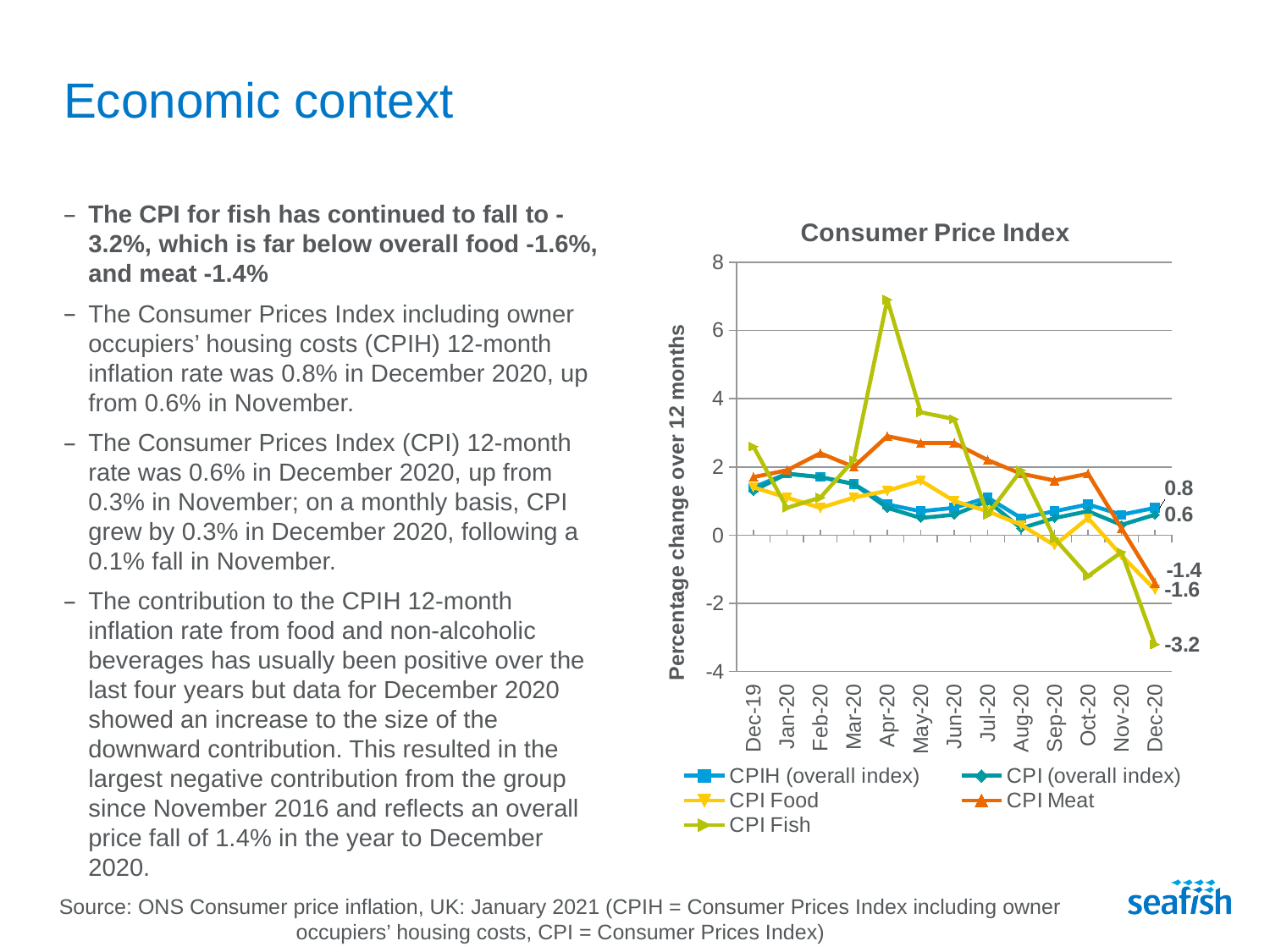
What is the value for CPI Fish in Dec-20? -3.2 What is the value for CPI Food in Dec-20? -1.6 Does the CPI Fish line rise or fall from Apr-20 to Dec-20? fall How many months are shown on the x axis of the Consumer Price Index chart? 13 What type of chart is the Consumer Price Index chart? line chart Is the value for CPI Fish in Apr-20 greater or less than 6? greater What is the difference between CPIH (overall index) and CPI (overall index) in Dec-20? 0.2 What is the y-axis title of the Consumer Price Index chart? Percentage change over 12 months What is the value for CPI Meat in Dec-20? -1.4 What is the value for CPIH (overall index) in Dec-20? 0.8 Which series has the lowest value in Dec-20? CPI Fish How many series does the legend of the Consumer Price Index chart list? 5